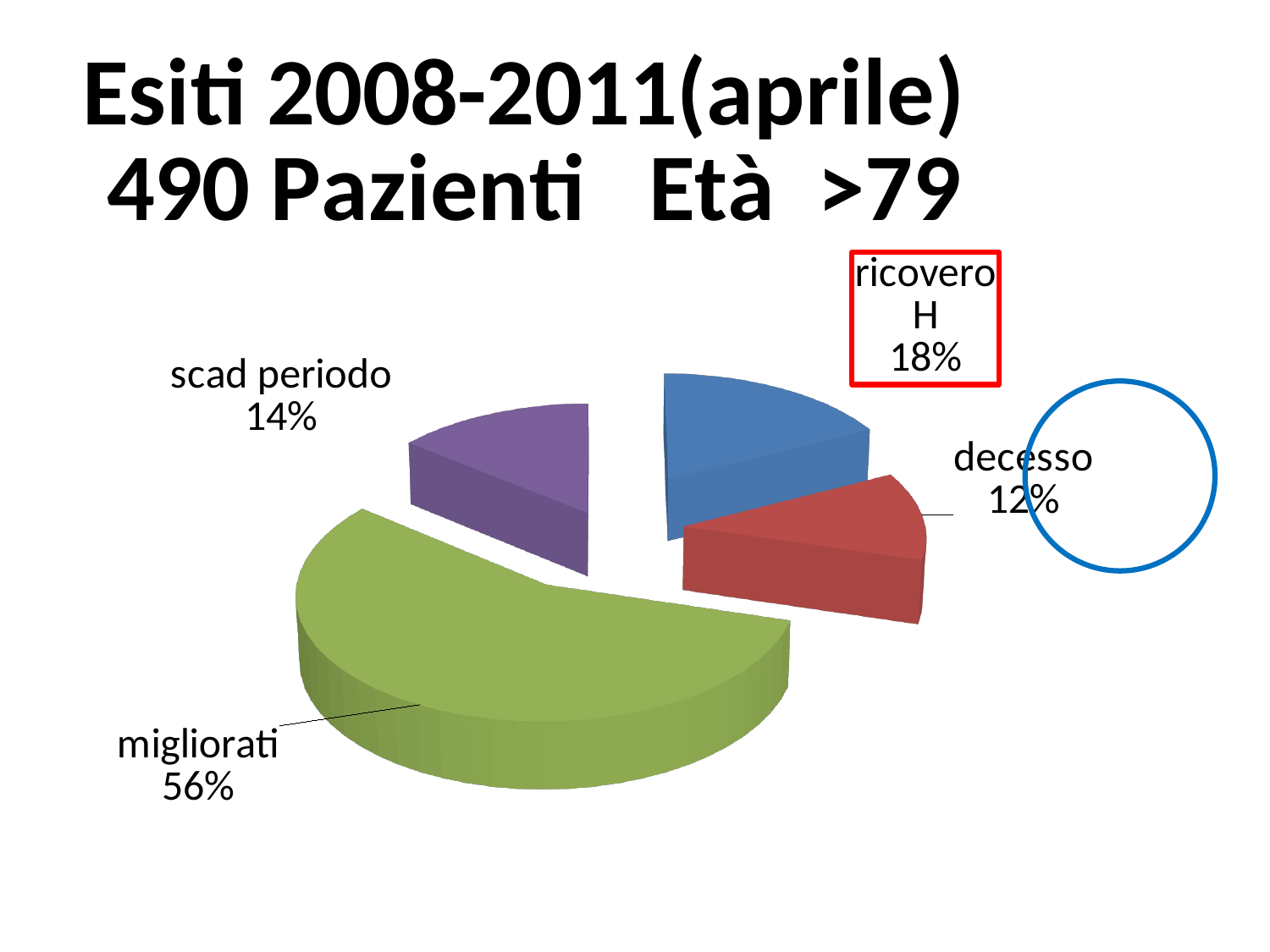
How many slices does the pie chart have? 4 Which is larger, the share for "scad periodo" or the share for "decesso"? scad periodo What share of the pie is labelled "ricovero H"? 18% What is the difference in percentage points between "migliorati" and "ricovero H"? 38 What share of the pie is labelled "scad periodo"? 14% What colour is the "migliorati" slice? green What share of the pie is labelled "migliorati"? 56% Which category has the largest slice of the pie? migliorati Which category has the smallest slice of the pie? decesso What is the difference in percentage points between "ricovero H" and "decesso"? 6 What kind of chart is shown on the slide? pie chart